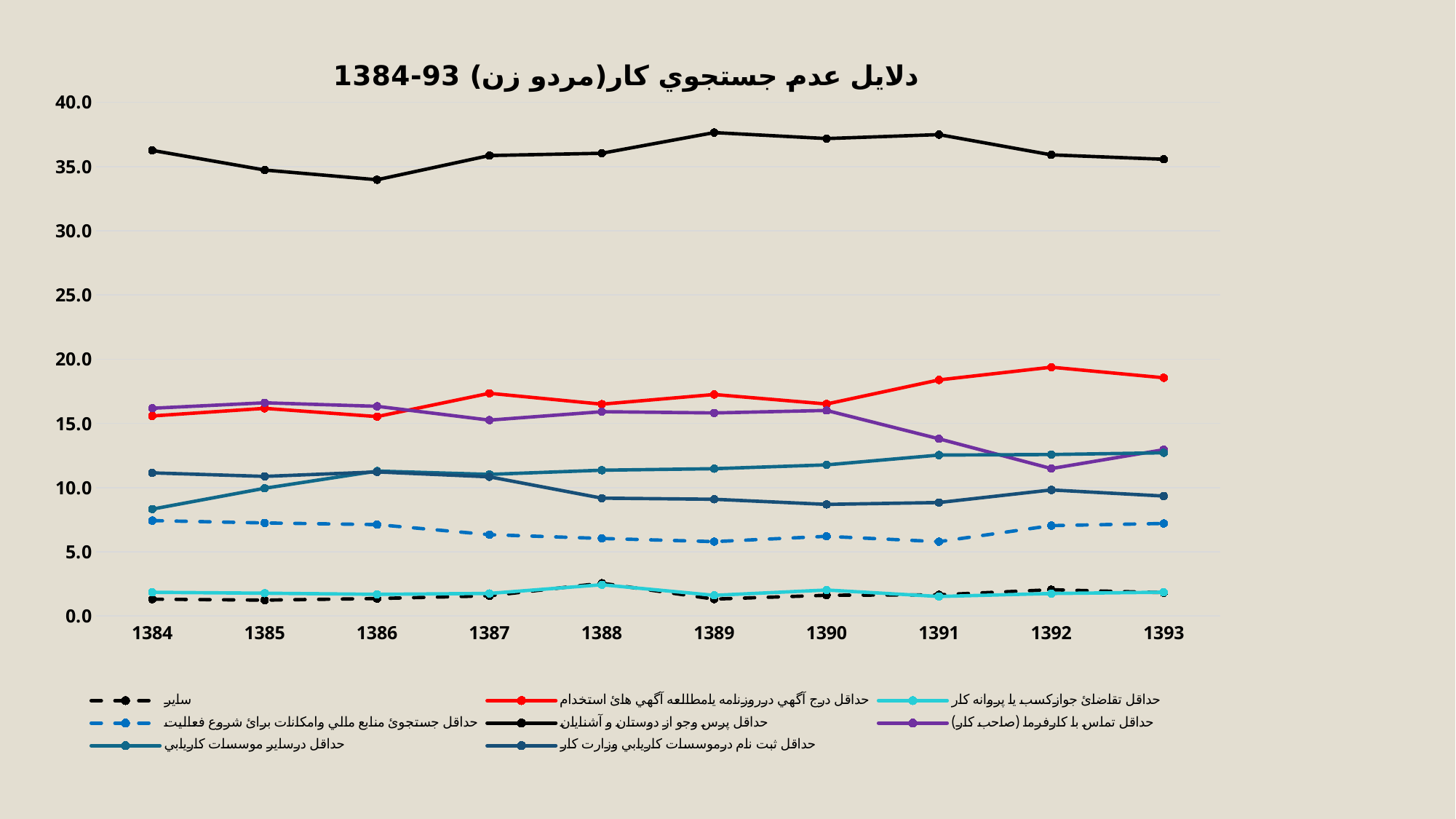
Which series has the highest values across all years? حداقل پرس و جو از دوستان و آشنایان In which year does the حداقل تماس با کارفرما (صاحب کار) series reach its lowest value? 1392 Is the value for حداقل درج آگهی در روزنامه یا مطالعه آگهی های استخدام in 1392 greater or less than 20? less How many years are plotted along the x axis? 10 Is the value for حداقل تماس با کارفرما (صاحب کار) in 1392 greater or less than 10? greater Is the value for حداقل تقاضای جواز کسب یا پروانه کار in 1388 greater or less than 5? less Does the حداقل تماس با کارفرما (صاحب کار) series rise or fall from 1390 to 1392? fall What is the title of the chart? دلایل عدم جستجوی کار(مردو زن) 1384-93 How many series does the legend list? 8 What kind of chart is shown on the slide? line chart In 1393, which is larger: حداقل درج آگهی در روزنامه یا مطالعه آگهی های استخدام or حداقل تماس با کارفرما (صاحب کار)? حداقل درج آگهی در روزنامه یا مطالعه آگهی های استخدام